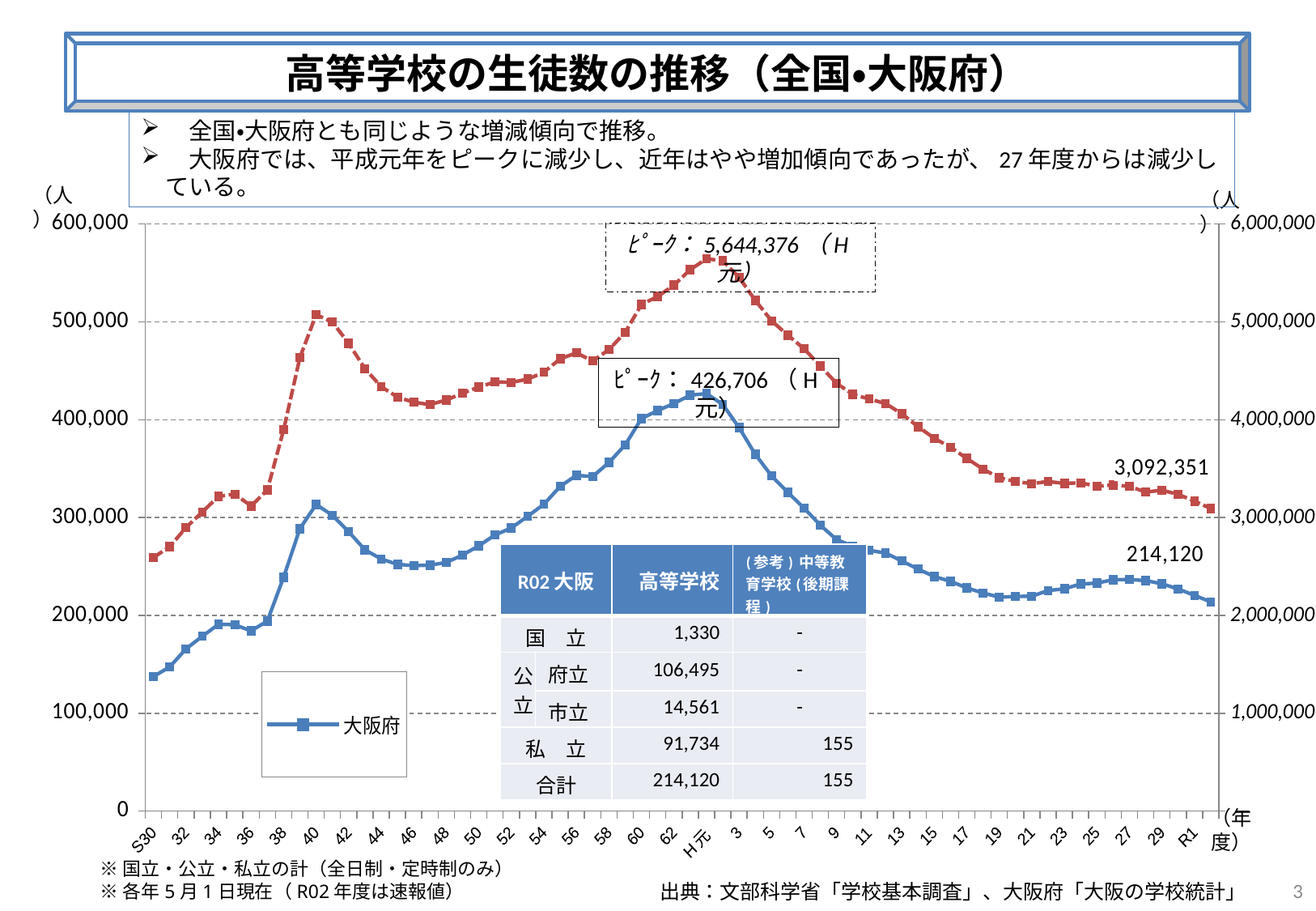
What kind of chart is shown on the slide? line chart What is the difference between the national peak value and its final labelled value? 2,552,025 In which year does the 大阪府 series reach its peak? H元 What is the peak value labelled for the 大阪府 series? 426,706 Is the 大阪府 value at S30 greater or less than 200,000? less Is the 大阪府 value at year 40 greater or less than 300,000? greater What is the peak value labelled for the upper (red) national series? 5,644,376 What is the maximum value shown on the left vertical axis? 600,000 Does the 大阪府 series rise or fall from H元 to year 11? fall What is the value labelled at the right end of the upper (red) national series? 3,092,351 What is the difference between the 大阪府 peak value and its final labelled value? 212,586 What is the value labelled at the right end of the 大阪府 series? 214,120